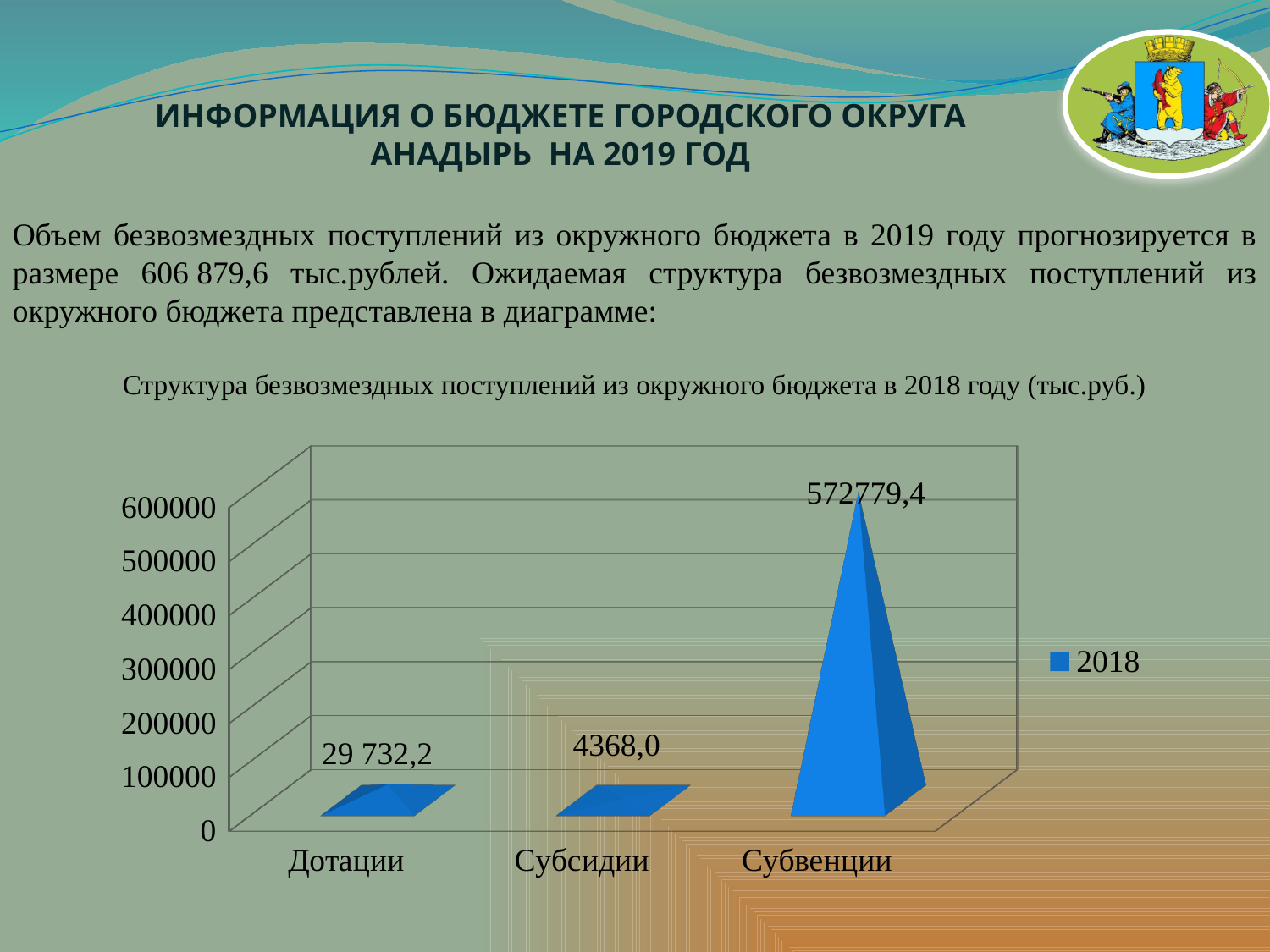
Is the value for Субвенции greater or less than 500000? greater What is the difference between the values for Субвенции and Дотации? 543047,2 What is the value for Субсидии? 4368,0 Which category has the highest value? Субвенции Which category has the lowest value? Субсидии What is the difference between the values for Дотации and Субсидии? 25364,2 Which is larger, the value for Дотации or the value for Субсидии? Дотации How many series does the legend list? 1 How many categories are shown on the x axis? 3 What is the value for Дотации? 29 732,2 What kind of chart is shown on the slide? bar chart What is the value for Субвенции? 572779,4